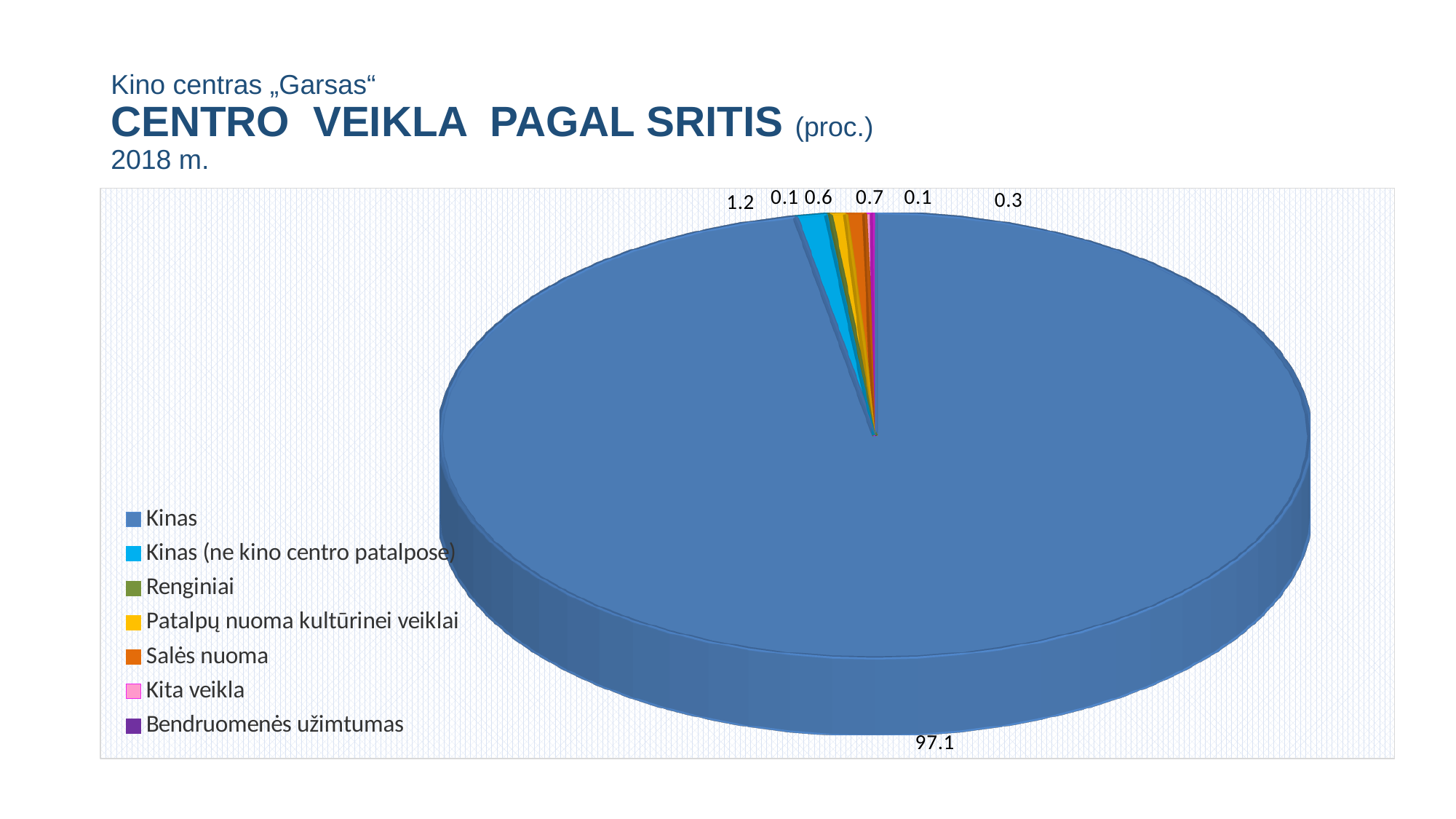
What year does the chart refer to? 2018 m. What is the value for Kinas (ne kino centro patalpose)? 1.2 What is the value for Kinas? 97.1 How many categories does the legend list? 7 What type of chart is shown on the slide? pie chart What share of the pie does Kinas represent? 97.1 What is the main title of the chart? CENTRO VEIKLA PAGAL SRITIS (proc.) Which is larger, the value for Kinas or the value for Kinas (ne kino centro patalpose)? Kinas What is the difference between the value for Kinas and the value for Kinas (ne kino centro patalpose)? 95.9 Which category has the largest slice of the pie? Kinas